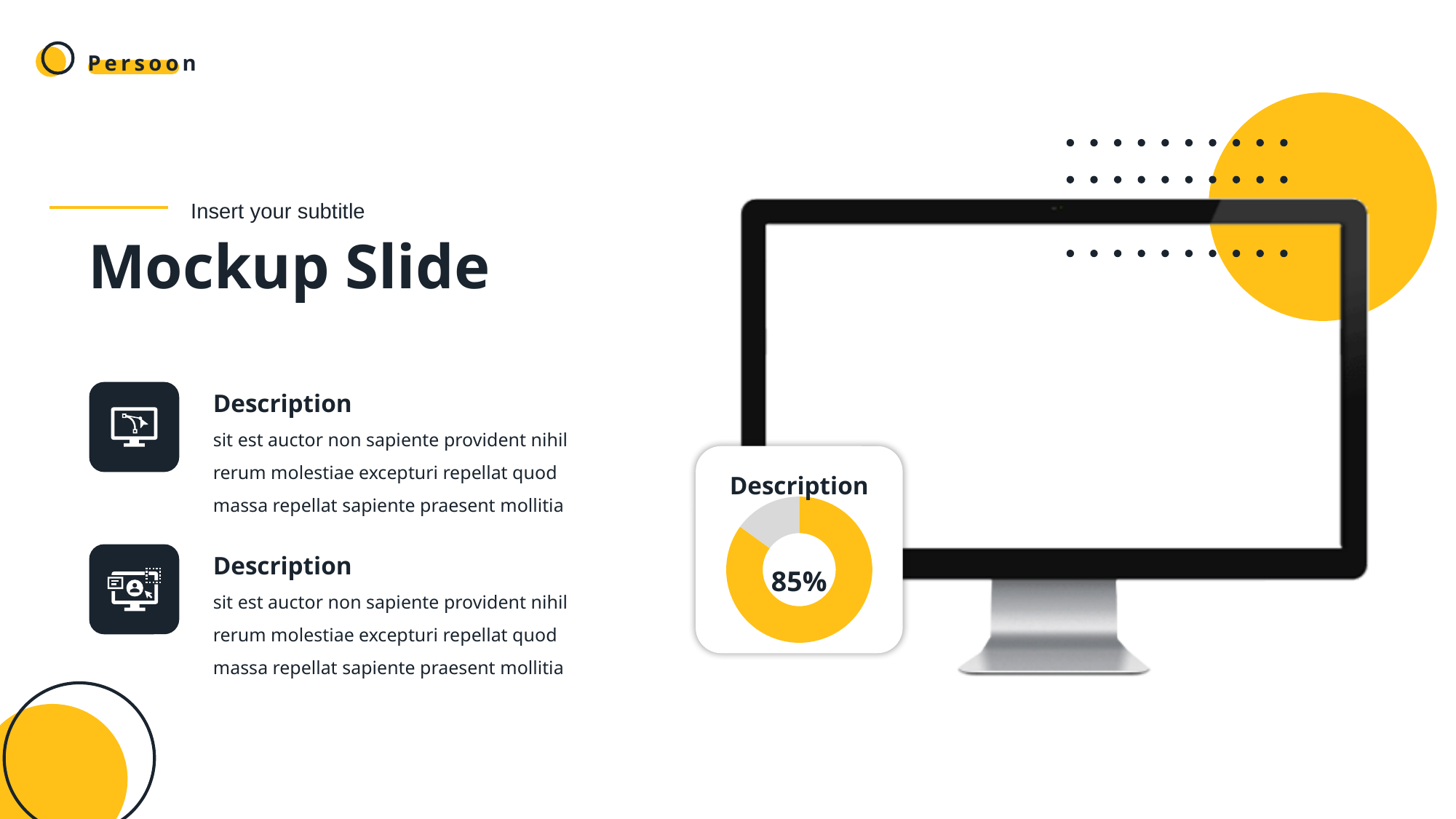
How many segments does the doughnut chart have? 2 What is the difference between the yellow segment's share and the grey segment's share in the doughnut chart? 70% What colour is the larger segment of the doughnut chart? Yellow What kind of chart is shown in the card labelled "Description" on the slide? Doughnut chart What percentage is printed in the centre of the doughnut chart? 85% What is the title printed above the doughnut chart? Description Is the value shown in the doughnut chart greater or less than 50%? greater What share of the doughnut chart does the grey segment represent? 15% What share of the doughnut chart does the yellow segment represent? 85% Which segment of the doughnut chart is larger, the yellow one or the grey one? Yellow